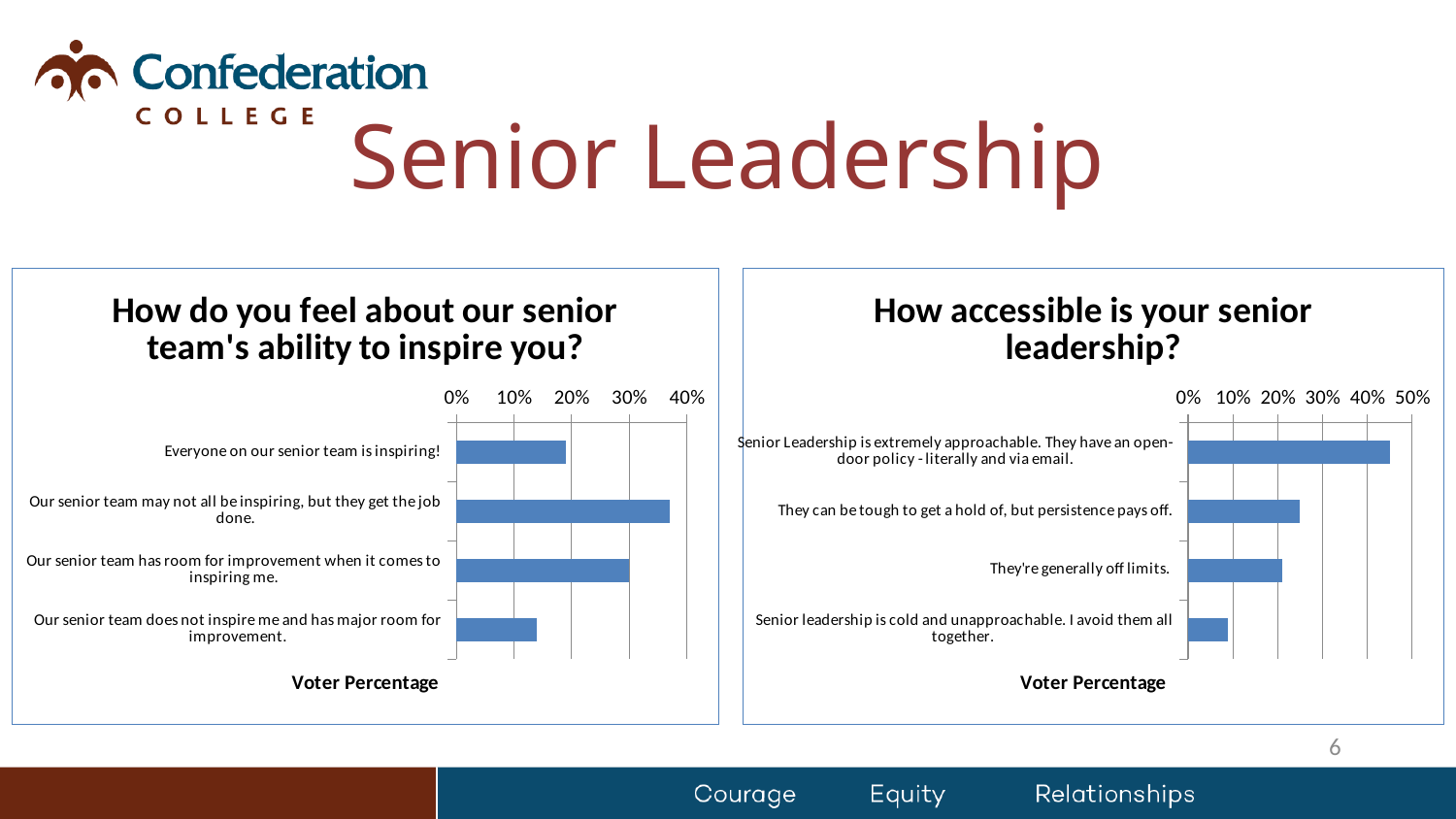
In the chart 'How accessible is your senior leadership?', which is larger: the value for 'They can be tough to get a hold of, but persistence pays off.' or 'They're generally off limits.'? They can be tough to get a hold of, but persistence pays off. In the chart 'How accessible is your senior leadership?', is the value for 'Senior Leadership is extremely approachable...' greater or less than 40%? greater In the chart 'How do you feel about our senior team's ability to inspire you?', how many categories are shown? 4 In the chart 'How accessible is your senior leadership?', which category has the highest value? Senior Leadership is extremely approachable. They have an open-door policy - literally and via email. What type of chart is 'How accessible is your senior leadership?'? bar chart In the chart 'How do you feel about our senior team's ability to inspire you?', is the value for 'Our senior team may not all be inspiring, but they get the job done.' greater or less than 30%? greater In the chart 'How do you feel about our senior team's ability to inspire you?', which category has the lowest value? Our senior team does not inspire me and has major room for improvement. In the chart 'How accessible is your senior leadership?', which category has the lowest value? Senior leadership is cold and unapproachable. I avoid them all together. In the chart 'How do you feel about our senior team's ability to inspire you?', which category has the highest value? Our senior team may not all be inspiring, but they get the job done. What is the axis label shown below the bars in the chart 'How accessible is your senior leadership?'? Voter Percentage